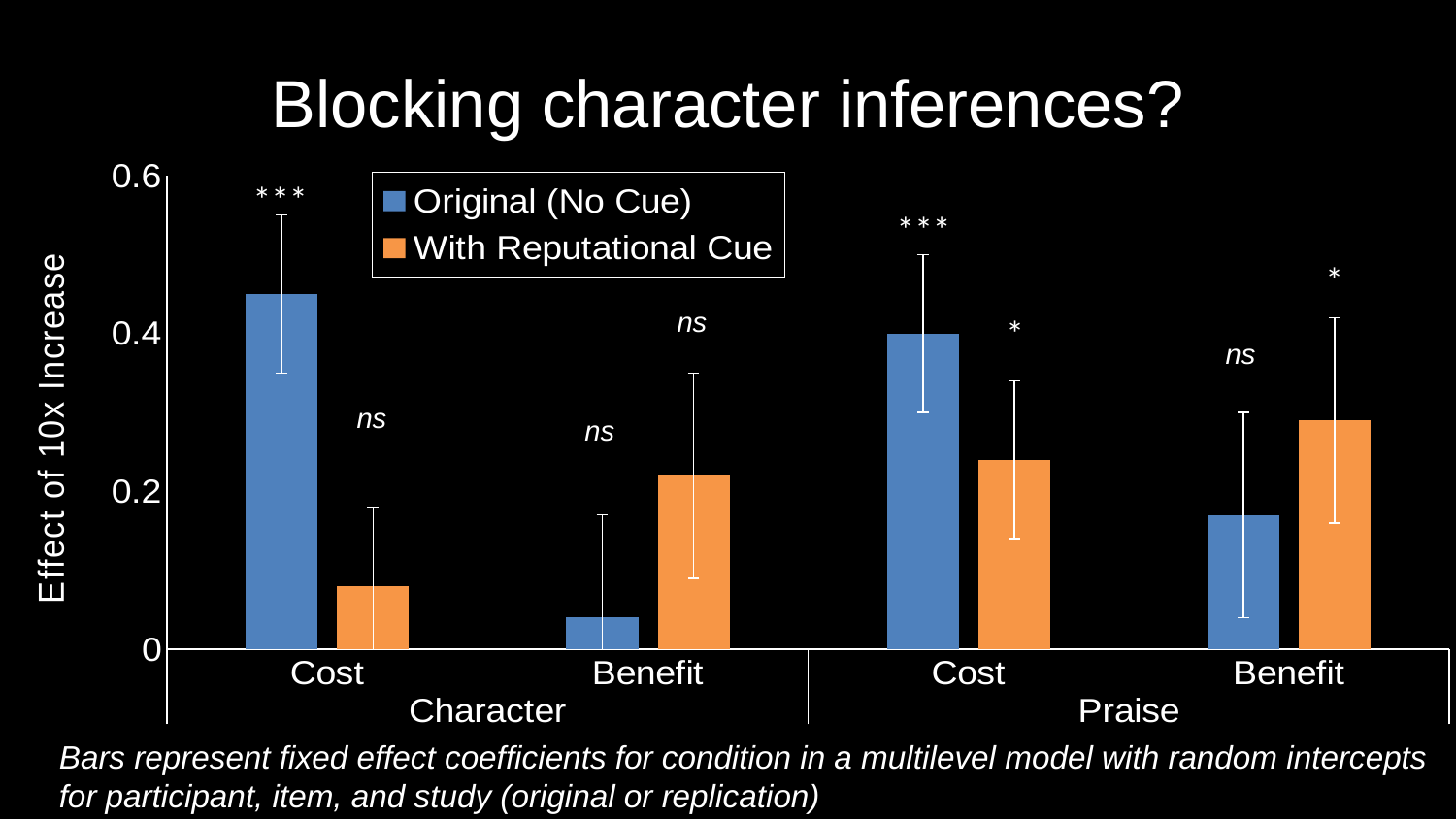
How many series does the legend list? 2 Is the Original (No Cue) value for Cost under Character greater or less than 0.4? greater What kind of chart is shown on the slide? bar chart Is the With Reputational Cue value for Cost under Character greater or less than 0.2? less For Benefit under Character, which is larger: Original (No Cue) or With Reputational Cue? With Reputational Cue What are the two series named in the legend? Original (No Cue) and With Reputational Cue How many bars are plotted in total across both panels? 8 What is the label on the y axis? Effect of 10x Increase Which bar is the highest in the whole chart? Original (No Cue) for Cost under Character Is the With Reputational Cue value for Benefit under Praise greater or less than 0.2? greater Which bar is the lowest in the whole chart? Original (No Cue) for Benefit under Character For Cost under Praise, which is larger: Original (No Cue) or With Reputational Cue? Original (No Cue)